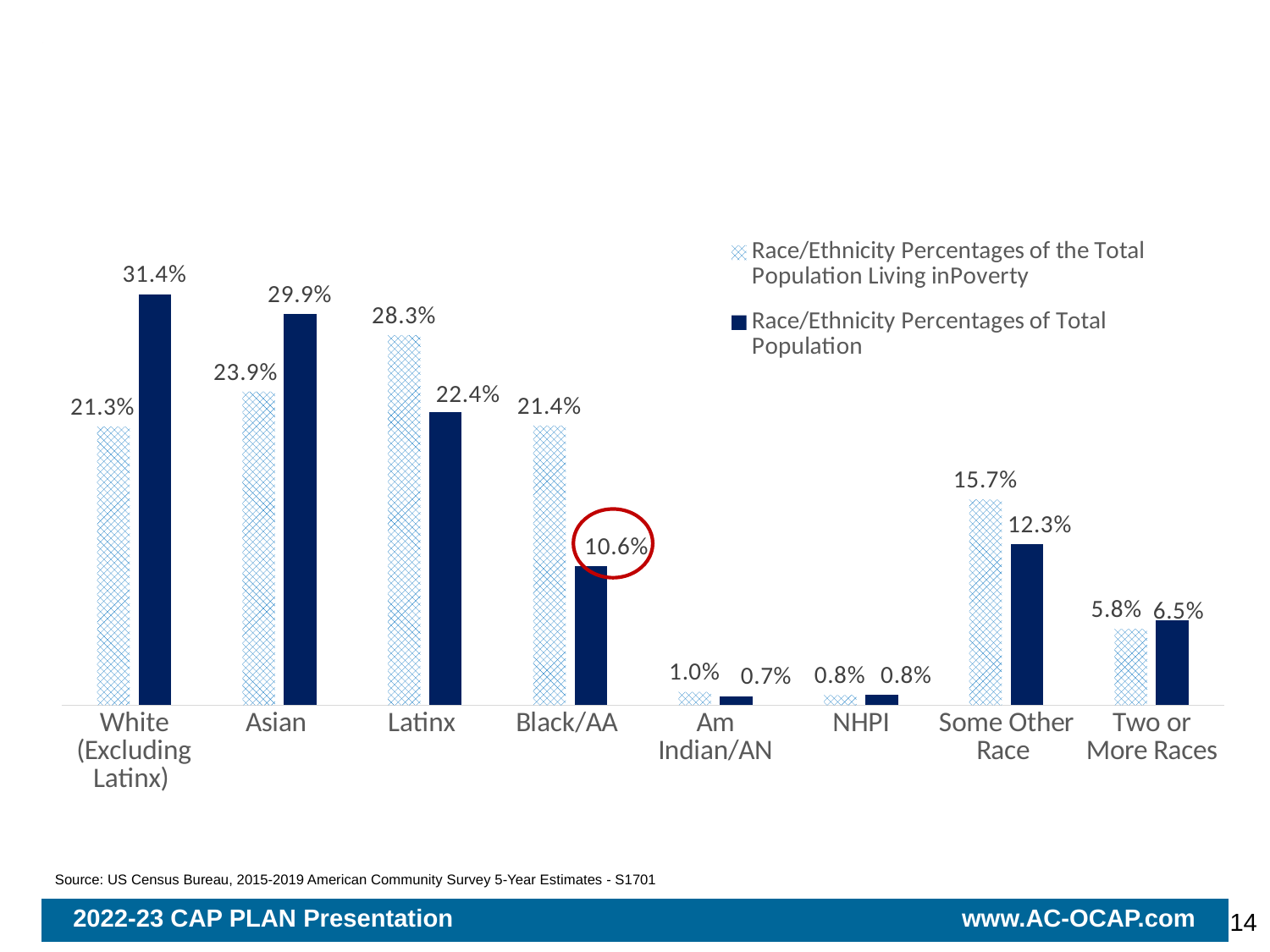
What is the Race/Ethnicity Percentage of Total Population for Black/AA? 10.6% What kind of chart is shown on the slide? Bar chart What is the difference between the Percentage of the Total Population Living in Poverty and the Percentage of Total Population for Black/AA? 10.8% For Asian, which is larger: the Percentage of the Total Population Living in Poverty or the Percentage of Total Population? Percentage of Total Population Which category has the lowest Race/Ethnicity Percentage of Total Population? Am Indian/AN How many series does the legend list? 2 What is the Race/Ethnicity Percentage of the Total Population Living in Poverty for Some Other Race? 15.7% What is the Race/Ethnicity Percentage of Total Population for White (Excluding Latinx)? 31.4% How many race/ethnicity categories are shown on the x axis? 8 Which value on the chart is circled in red? 10.6% Which category has the highest Race/Ethnicity Percentage of the Total Population Living in Poverty? Latinx What is the Race/Ethnicity Percentage of the Total Population Living in Poverty for Latinx? 28.3%